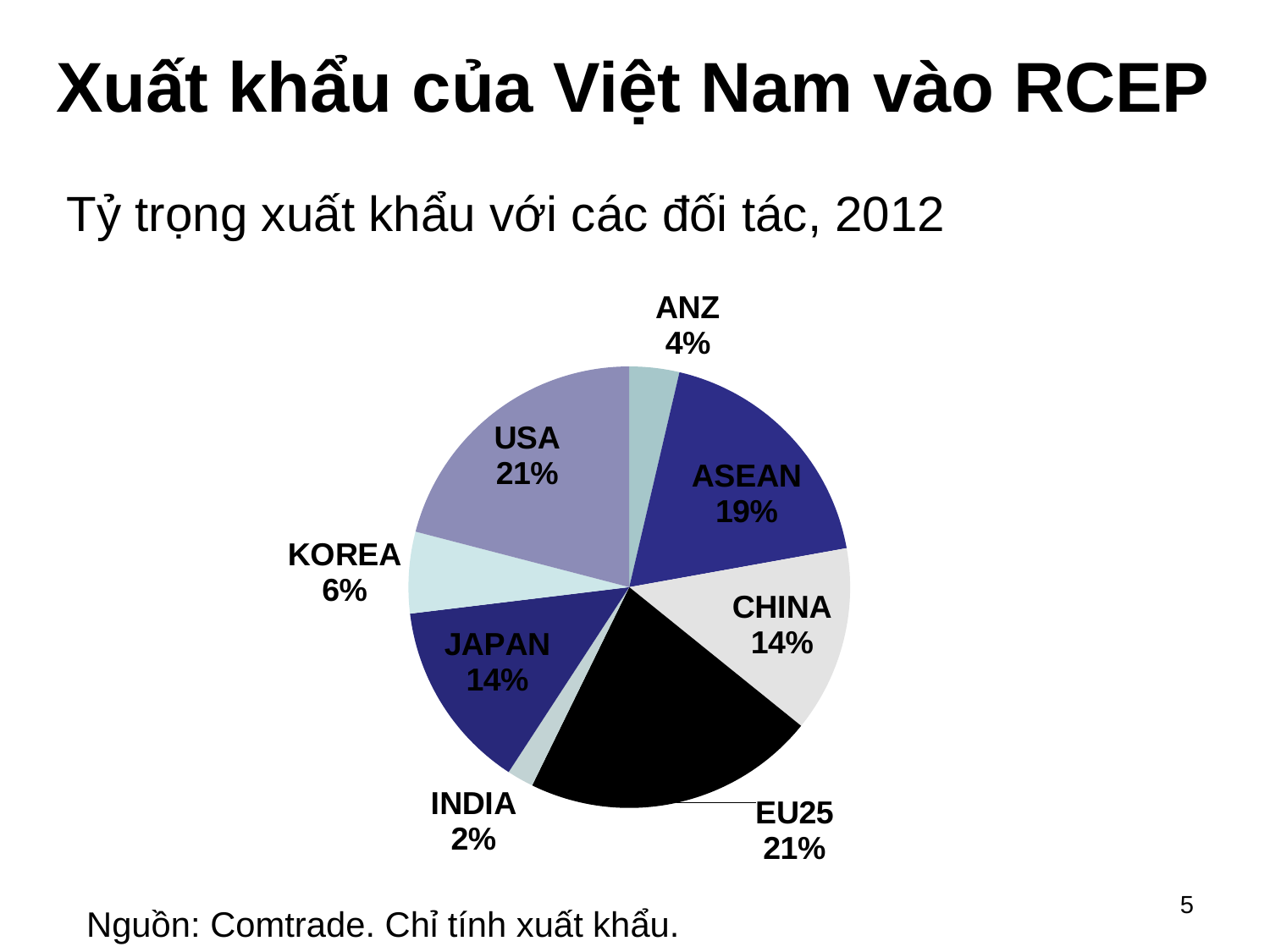
What share of exports goes to KOREA? 6% What share of exports goes to EU25? 21% What is the subtitle above the chart? Tỷ trọng xuất khẩu với các đối tác, 2012 Which partner has the smallest share of exports? INDIA What share of exports goes to ANZ? 4% What kind of chart is shown on the slide? pie chart Which is larger, the share for ASEAN or the share for JAPAN? ASEAN What share of exports goes to CHINA? 14% What is the difference in percentage points between the USA share and the KOREA share? 15 What is the combined share of JAPAN and CHINA? 28% How many slices does the pie chart have? 8 What share of exports goes to ASEAN? 19%